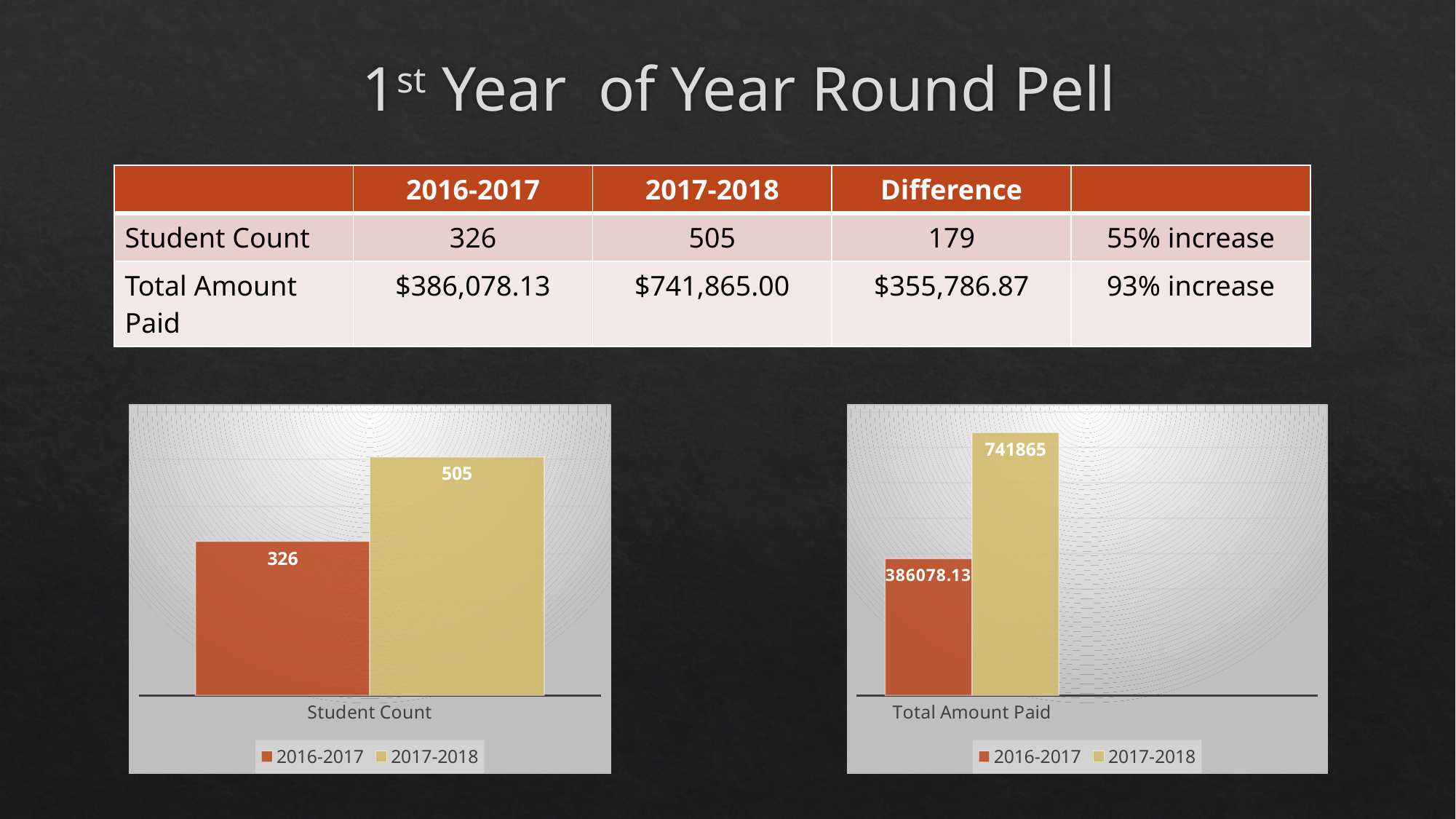
How many categories are shown on the x axis of the Student Count chart on the left? 1 In the Student Count chart on the left, which series has the higher value? 2017-2018 In the Total Amount Paid chart on the right, is the 2017-2018 value larger or smaller than the 2016-2017 value? larger In the Student Count chart on the left, what is the difference between the 2017-2018 and 2016-2017 values? 179 In the Student Count chart on the left, what is the value for 2016-2017? 326 In the Total Amount Paid chart on the right, what is the value for 2017-2018? 741865 How many series does the legend of the Student Count chart on the left list? 2 What kind of chart is the Total Amount Paid chart on the right? bar chart In the Total Amount Paid chart on the right, what colour is the bar for 2017-2018? yellow In the Total Amount Paid chart on the right, which series has the lower value? 2016-2017 In the Total Amount Paid chart on the right, what is the value for 2016-2017? 386078.13 In the Student Count chart on the left, what is the value for 2017-2018? 505